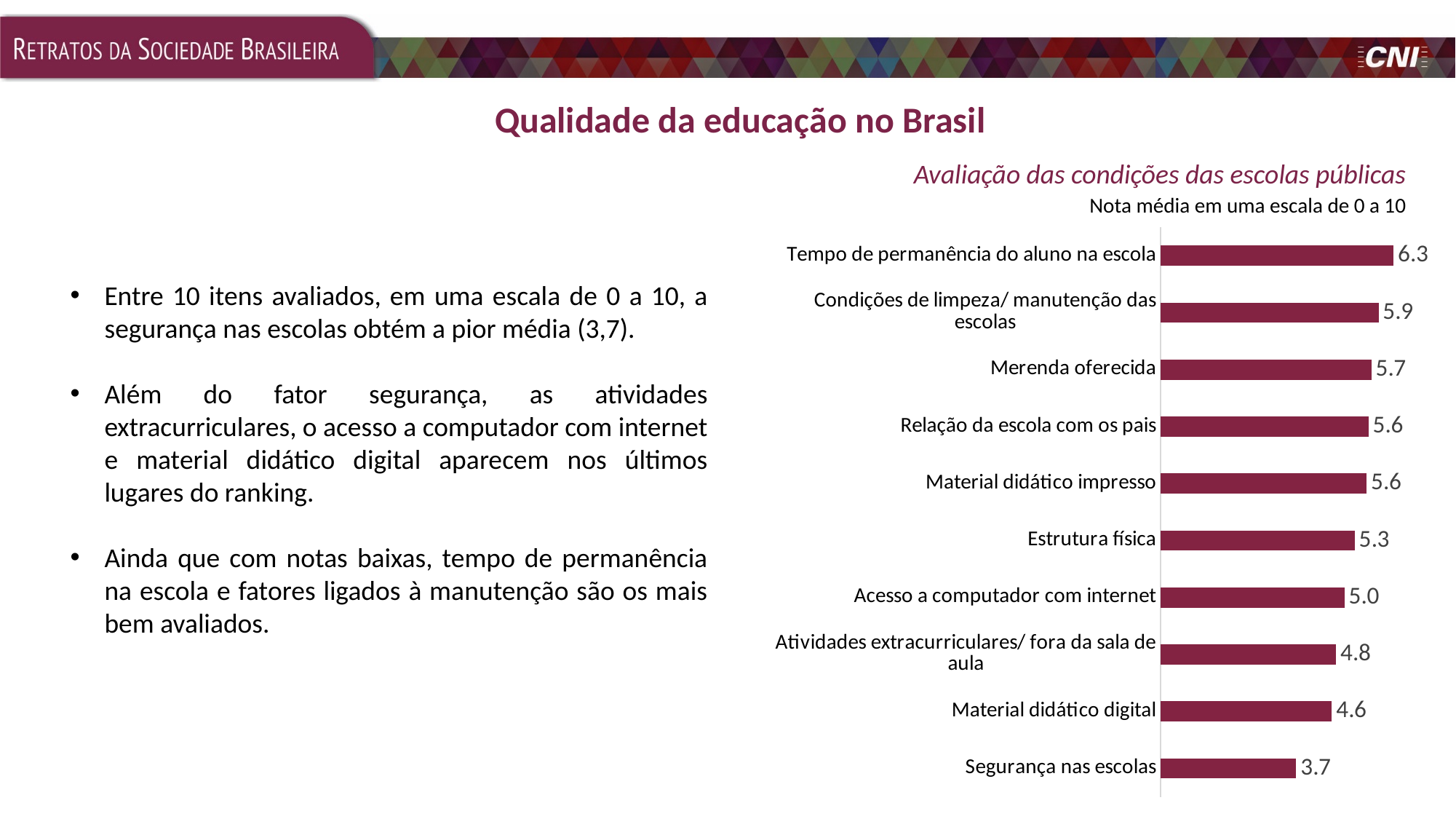
How many items are evaluated in the chart? 10 Which item has the lowest average score? Segurança nas escolas What is the difference between the scores for 'Tempo de permanência do aluno na escola' and 'Segurança nas escolas'? 2.6 What is the average score for 'Merenda oferecida'? 5.7 Which item has the highest average score? Tempo de permanência do aluno na escola What is the average score for 'Segurança nas escolas'? 3.7 What is the difference between the scores for 'Estrutura física' and 'Material didático digital'? 0.7 What type of chart is shown on the slide? Bar chart Which has a higher score: 'Merenda oferecida' or 'Atividades extracurriculares/ fora da sala de aula'? Merenda oferecida What is the average score for 'Acesso a computador com internet'? 5.0 What is the title of the chart? Avaliação das condições das escolas públicas What scale is used for the average scores, according to the chart subtitle? 0 a 10